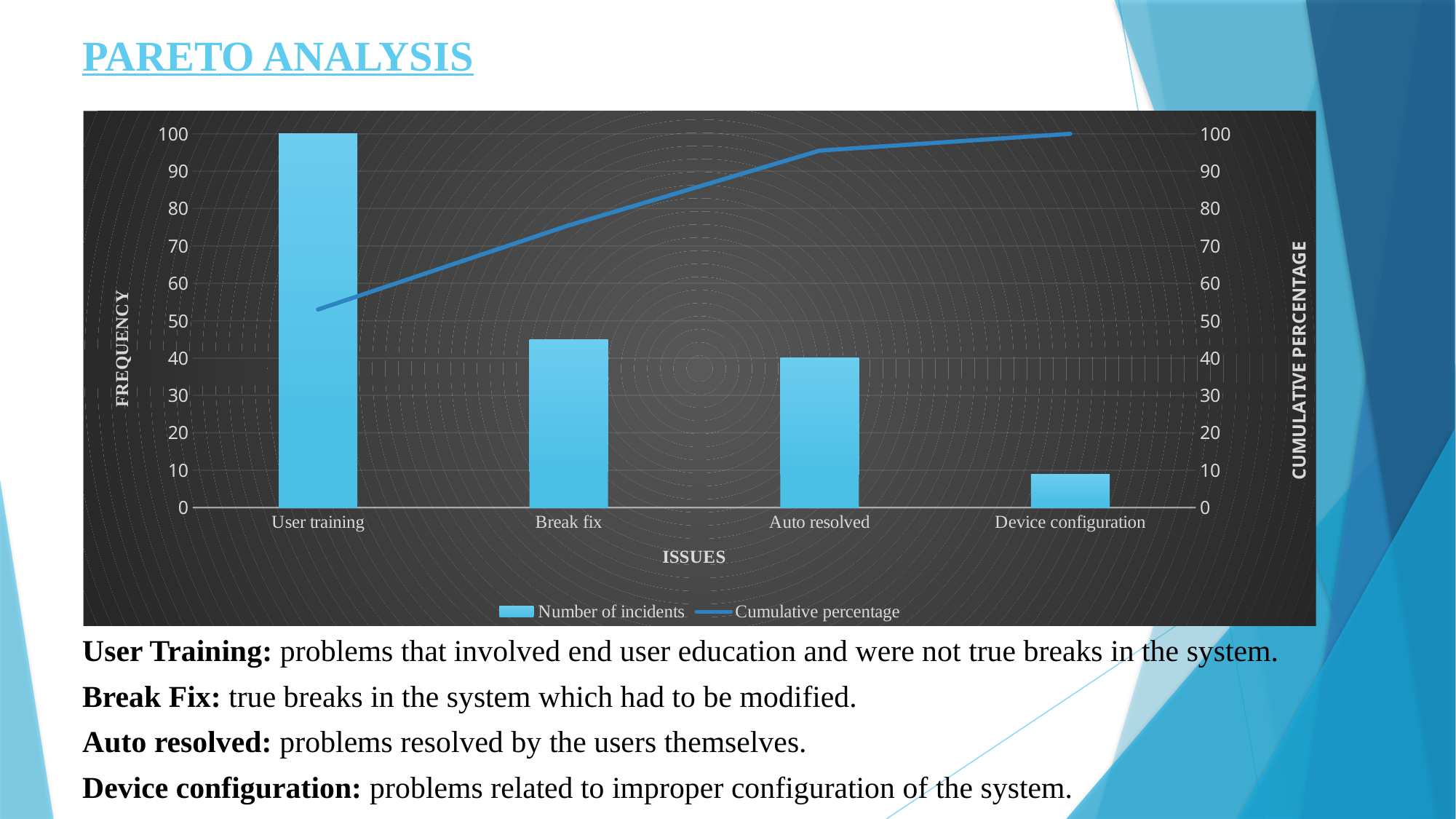
What is the number of incidents for Auto resolved? 40 Do the number of incidents rise or fall from left to right along the x axis? fall What kind of chart is shown on the slide? bar chart with a line Which issue has the lowest number of incidents? Device configuration What is the cumulative percentage at Device configuration? 100 Which issue has the highest number of incidents? User training Is the number of incidents for Break fix greater or less than 50? less How many issue categories are shown on the x axis? 4 How many series does the legend list? 2